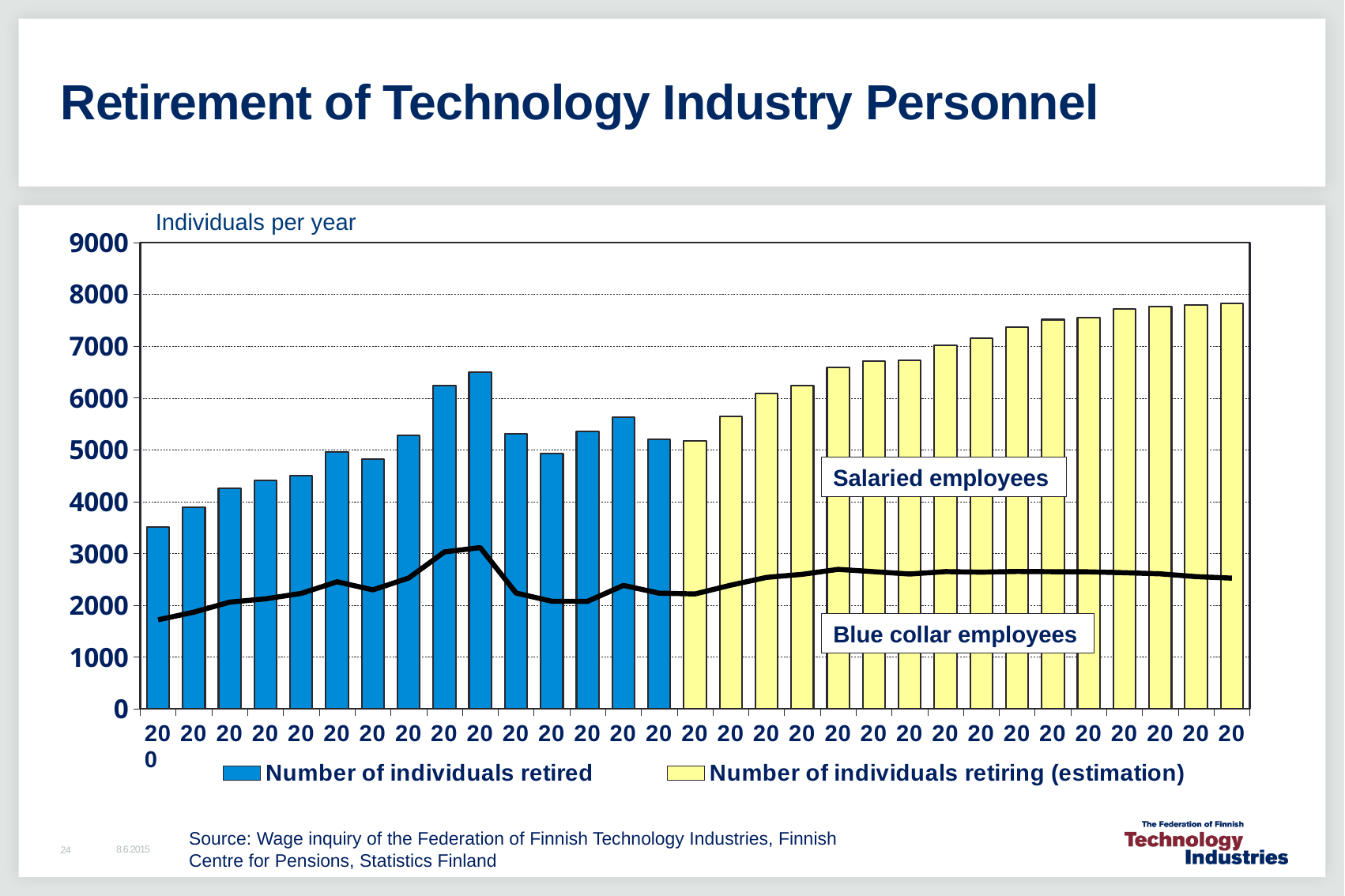
Is the lowest bar on the chart the leftmost or the rightmost bar? the leftmost bar Do the yellow estimation bars rise or fall from left to right? rise Is the value of the rightmost yellow bar greater or less than 7000? greater What does the label above the y axis say the values represent? Individuals per year Is the value of the rightmost yellow bar greater or less than 8000? less Is the tallest blue bar greater or less than 6000? greater What is the title of the slide's chart? Retirement of Technology Industry Personnel How many series does the legend list? 2 Which legend entry is shown in yellow? Number of individuals retiring (estimation) What type of chart is shown on the slide? Bar chart (with a line) Which is larger, the leftmost bar or the rightmost bar? the rightmost bar